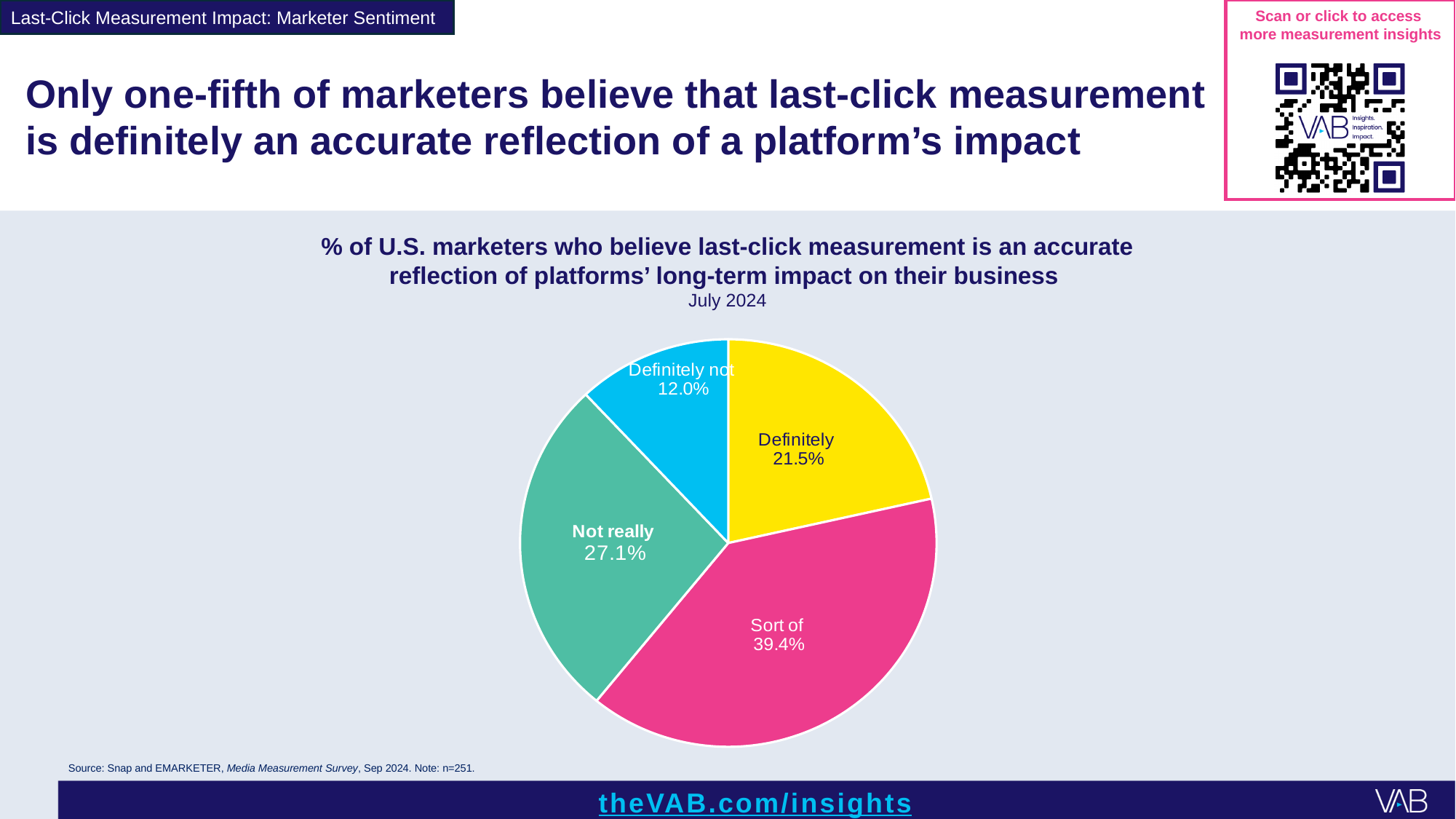
What is the difference in percentage points between "Sort of" and "Definitely"? 17.9 Which response has the smallest share of the pie? Definitely not What type of chart is shown on the slide? Pie chart What percentage of U.S. marketers answered "Definitely"? 21.5% What percentage of U.S. marketers answered "Not really"? 27.1% Which response has the largest share of the pie? Sort of What percentage of U.S. marketers answered "Sort of"? 39.4% How many response categories are shown in the pie chart? 4 What is the combined share of "Not really" and "Definitely not"? 39.1% What colour is the "Definitely" slice of the pie chart? Yellow What percentage of U.S. marketers answered "Definitely not"? 12.0% Which is larger, the share for "Not really" or the share for "Definitely"? Not really